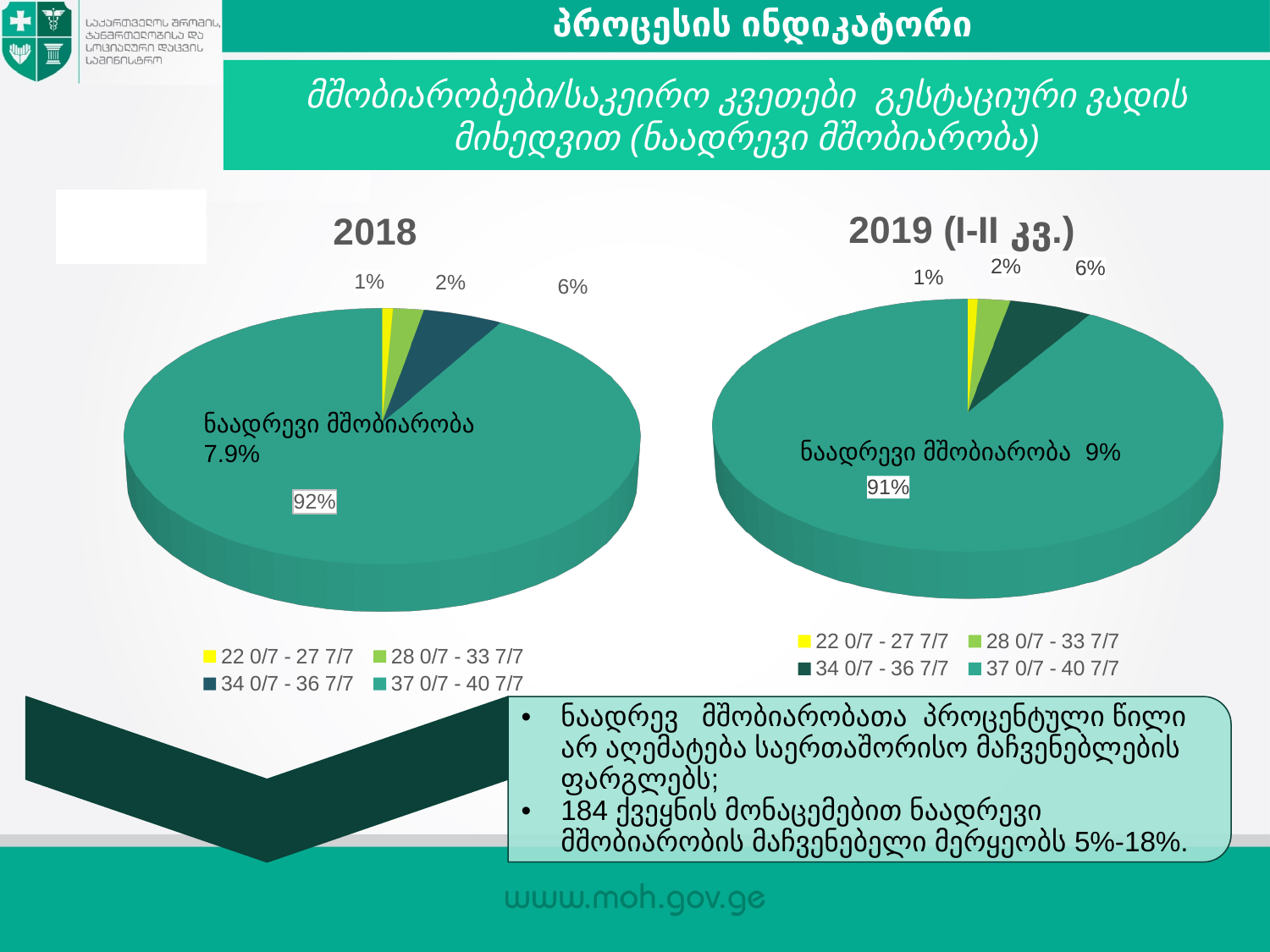
How many entries does the legend of the 2019 (I-II კვ.) chart list? 4 In the 2019 (I-II კვ.) chart, what is the value for 22 0/7 - 27 7/7? 1% In the 2019 (I-II კვ.) chart, which is larger: 34 0/7 - 36 7/7 or 28 0/7 - 33 7/7? 34 0/7 - 36 7/7 How many slices does the 2018 pie chart have? 4 In the 2018 chart, what is the value for 34 0/7 - 36 7/7? 6% In the 2018 chart, what share does the 37 0/7 - 40 7/7 slice have? 92% In the 2018 chart, what is the value for 28 0/7 - 33 7/7? 2% In the 2019 (I-II კვ.) chart, which category has the smallest slice? 22 0/7 - 27 7/7 In the 2019 (I-II კვ.) chart, what share does the 37 0/7 - 40 7/7 slice have? 91% In the 2018 chart, which category has the largest slice? 37 0/7 - 40 7/7 What kind of chart is the 2018 chart? pie chart What is the difference between the 37 0/7 - 40 7/7 share in the 2018 chart and in the 2019 (I-II კვ.) chart? 1%